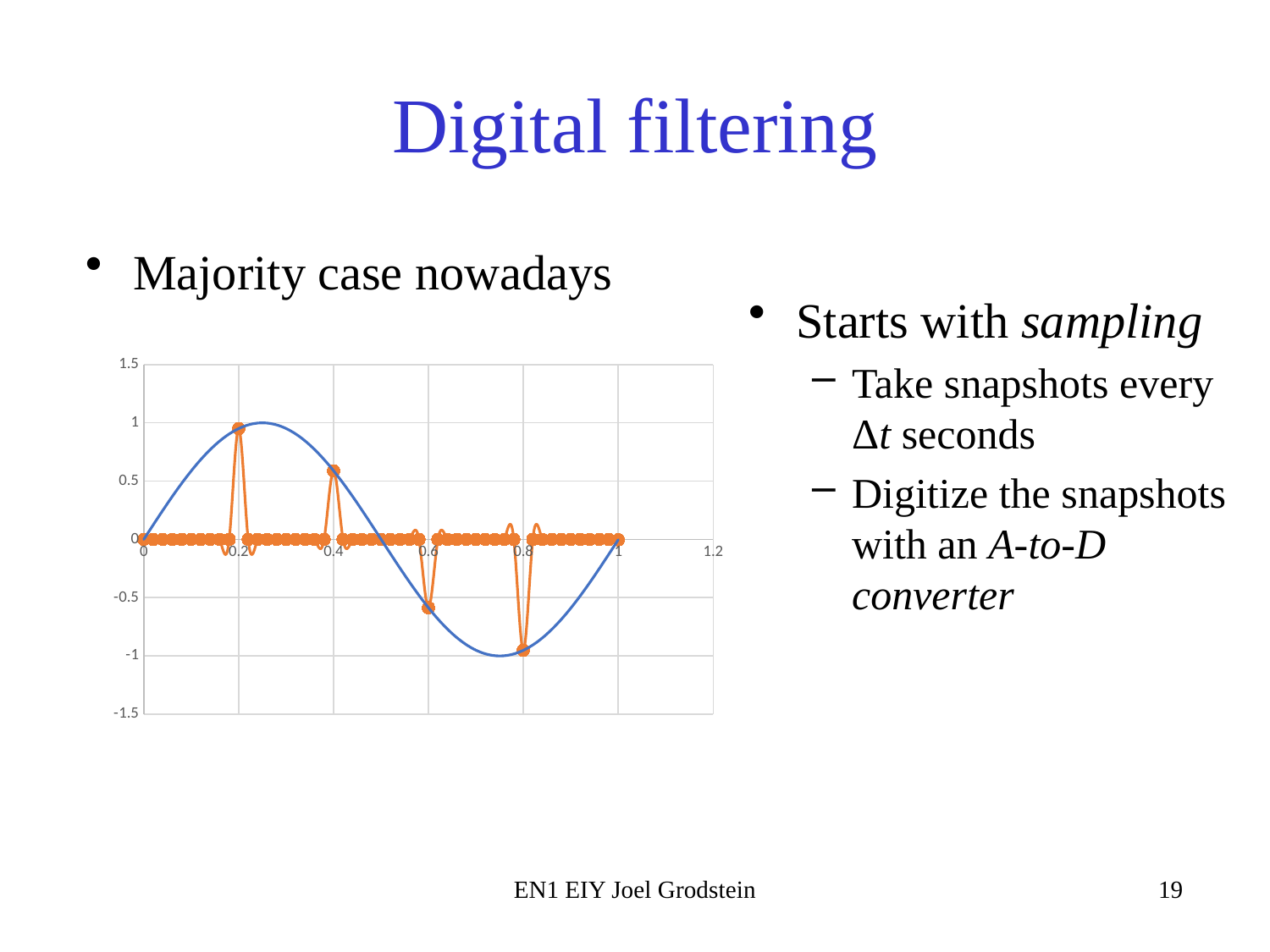
Is the peak value of the blue curve greater or less than 0.5? greater What kind of chart is shown on the slide? line chart Between x = 0 and x = 0.2, does the blue curve rise or fall? rise At which x value does the orange series reach its highest point? 0.2 How many non-zero orange spikes are plotted? 4 What is the highest tick value shown on the y axis? 1.5 Is the value of the orange spike at x = 0.2 greater or less than 0.5? greater At which x value does the orange series reach its lowest point? 0.8 Is the value of the orange spike at x = 0.8 greater or less than -0.5? less Which is larger, the orange spike at x = 0.2 or the orange spike at x = 0.4? the spike at x = 0.2 Between x = 0.4 and x = 0.6, does the blue curve rise or fall? fall